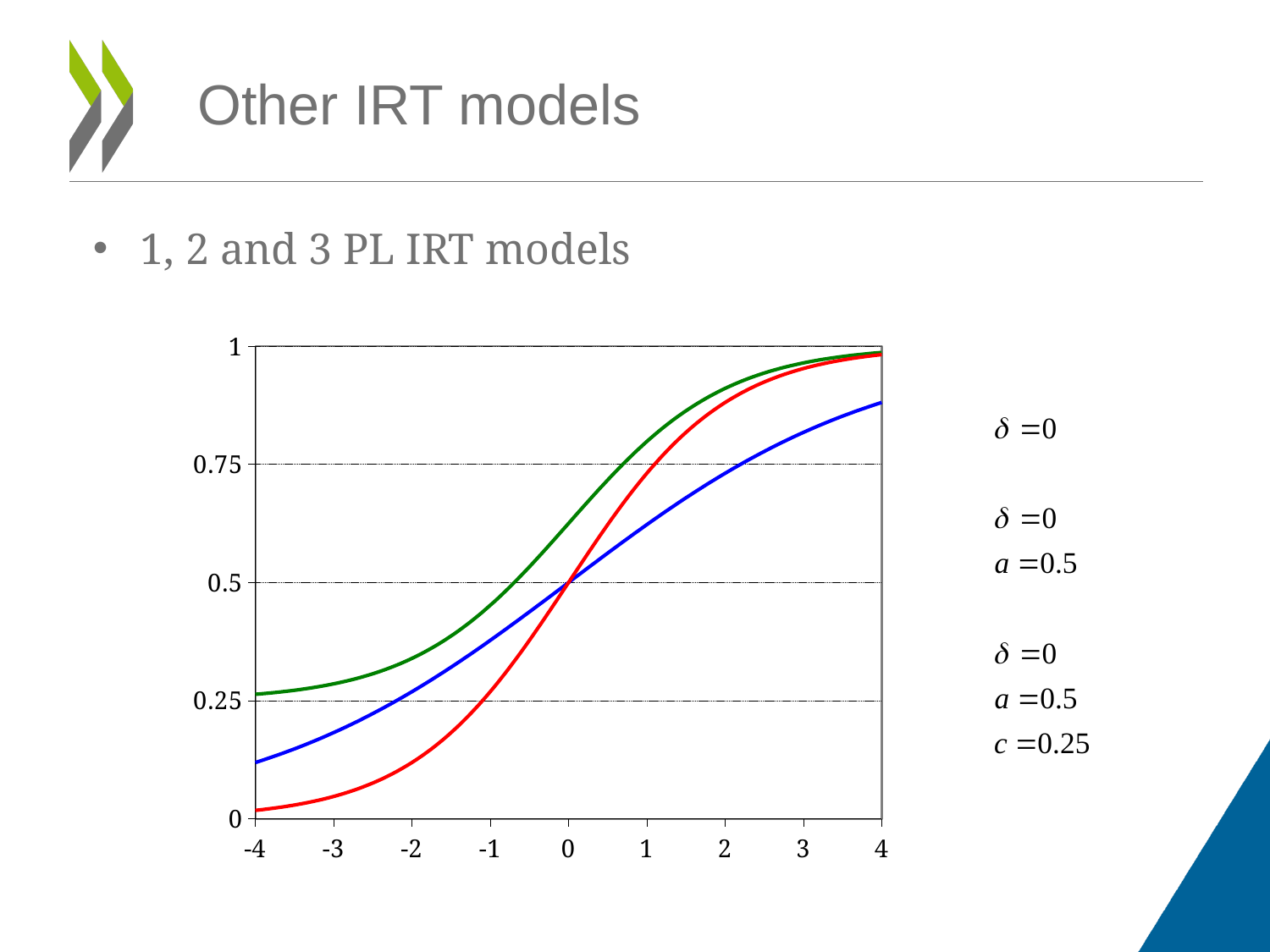
Do the curves rise or fall as the x axis goes from -4 to 4? rise What value does the red curve take at x = 0? 0.5 Is the value of the red curve at x = -4 greater or less than 0.25? less How many curves are plotted on the chart? 3 Is the value of the blue curve at x = -4 greater or less than 0.25? less At x = 4, which curve is higher, the blue one or the red one? red Which curve has the highest value at x = -4? green What kind of chart is shown on the slide? line chart Is the value of the red curve at x = 2 greater or less than 0.75? greater Which curve has the lowest value at x = 4? blue At x = -4, which curve is higher, the red one or the green one? green